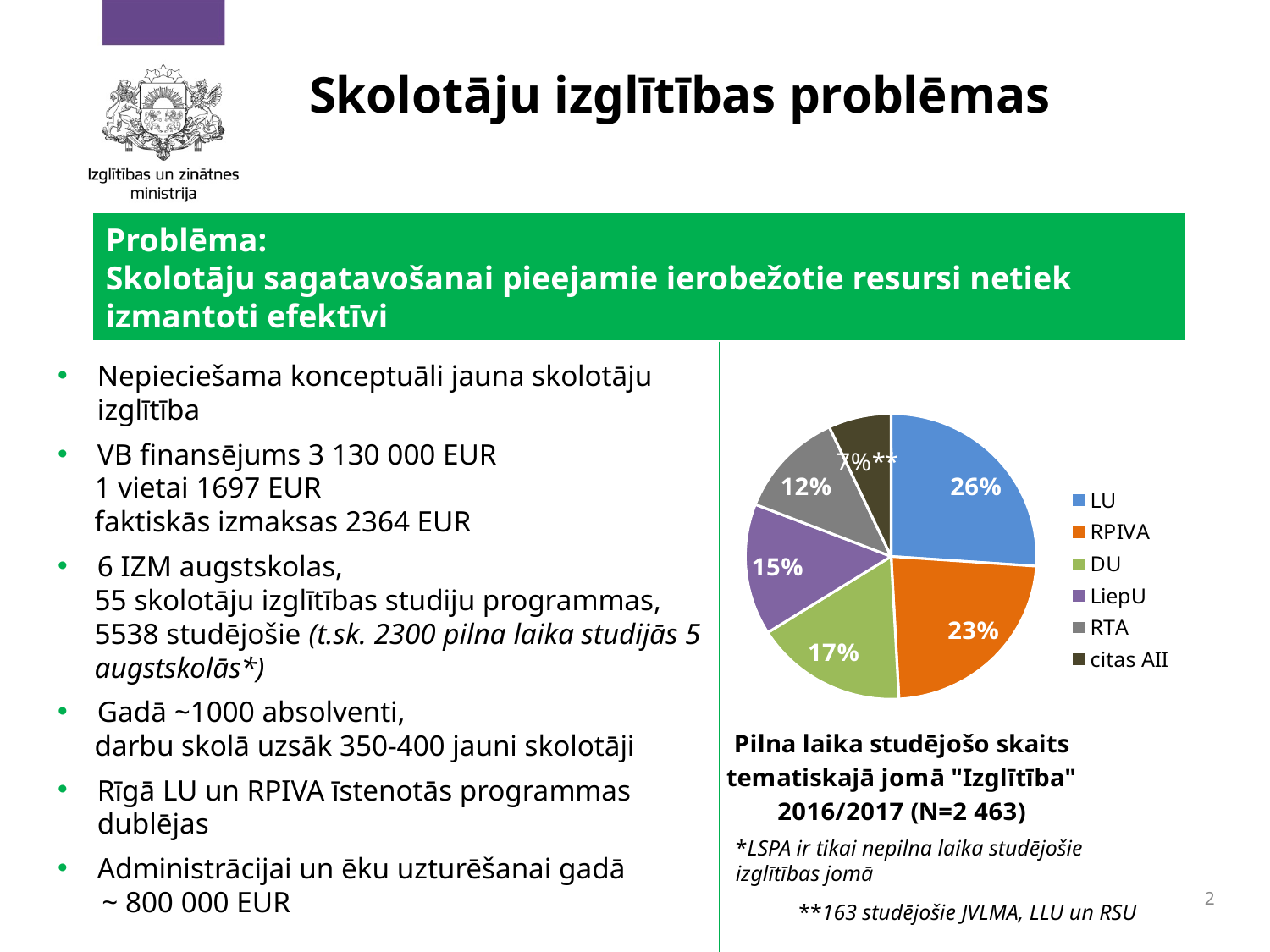
What share of the pie does RPIVA hold? 23% What share of the pie does DU hold? 17% What is the difference in percentage points between the LU and RPIVA slices? 3 Which category has the largest slice of the pie? LU What type of chart is shown on the slide? pie chart Which category has the smallest slice of the pie? citas AII What share of the pie does LU hold? 26% What share of the pie does RTA hold? 12% What share of the pie does LiepU hold? 15% What is the N value given in the chart title? 2 463 Which slice is larger, DU or RTA? DU How many entries does the legend list? 6